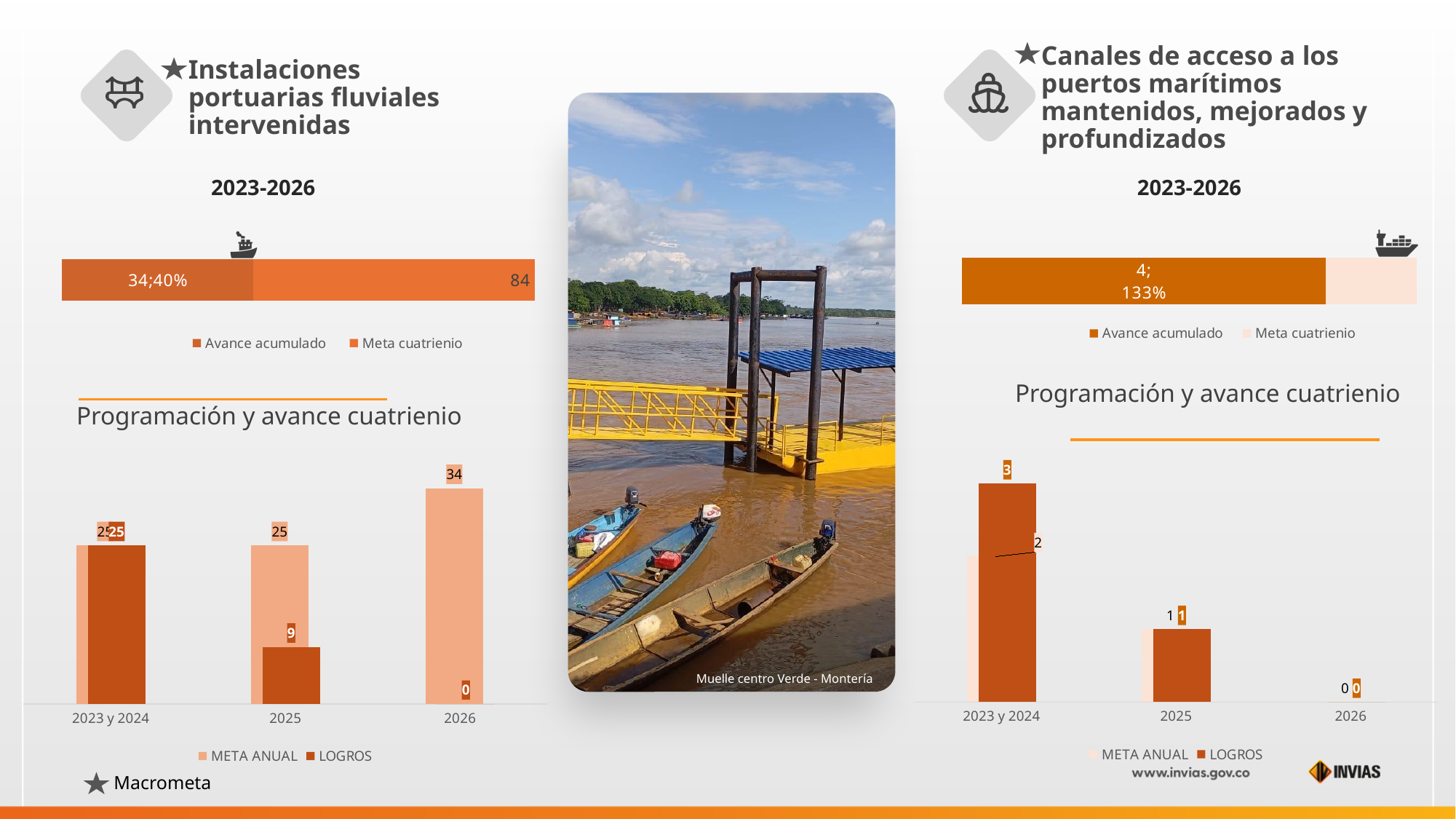
In the top-left chart under 'Instalaciones portuarias fluviales intervenidas', what label is shown on the Avance acumulado segment? 34;40% In the bottom-right chart 'Programación y avance cuatrienio', do the LOGROS values rise or fall from 2023 y 2024 to 2026? fall How many categories are shown on the x axis of the bottom-left chart 'Programación y avance cuatrienio'? 3 In the bottom-right chart 'Programación y avance cuatrienio', what is the LOGROS value for 2023 y 2024? 3 In the bottom-left chart 'Programación y avance cuatrienio', what is the META ANUAL value for 2026? 34 What kind of chart is the bottom-left 'Programación y avance cuatrienio' chart? bar chart In the bottom-left chart 'Programación y avance cuatrienio', what is the difference between META ANUAL and LOGROS for 2025? 16 In the bottom-left chart 'Programación y avance cuatrienio', which category has the highest META ANUAL value? 2026 In the bottom-right chart 'Programación y avance cuatrienio', what is the META ANUAL value for 2023 y 2024? 2 In the top-left chart under 'Instalaciones portuarias fluviales intervenidas', what is the Meta cuatrienio value? 84 How many series does the legend of the bottom-right chart 'Programación y avance cuatrienio' list? 2 In the bottom-left chart 'Programación y avance cuatrienio', what is the LOGROS value for 2025? 9